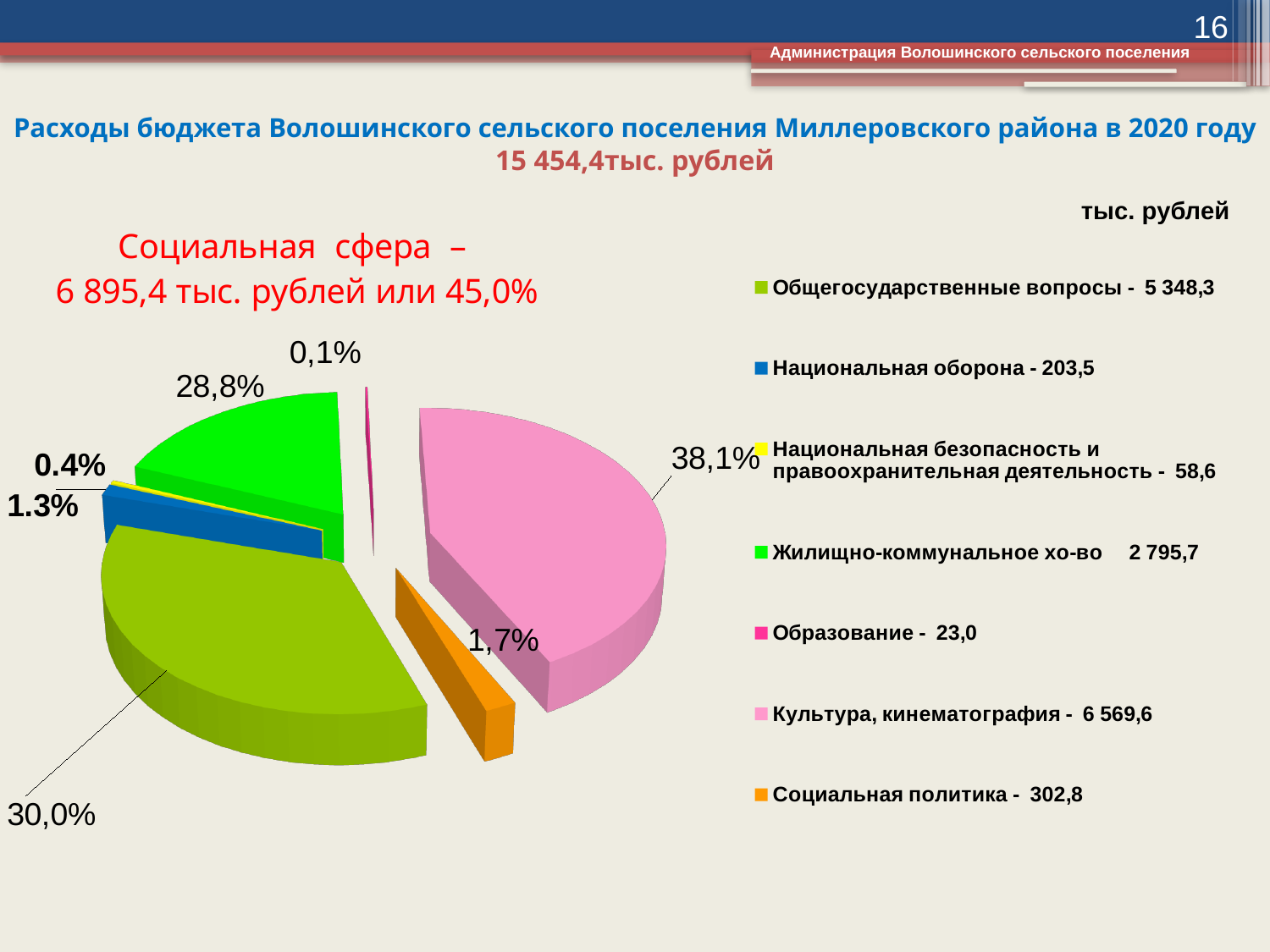
What value does the legend give for Образование? 23,0 What kind of chart is shown on the slide? pie chart What share of the pie is labelled for the Культура, кинематография slice? 38,1% How many categories does the legend of the pie chart list? 7 Which is larger: Национальная оборона or Социальная политика? Социальная политика Which category has the smallest slice of the pie? Образование Which category has the largest slice of the pie? Культура, кинематография What share of the pie is labelled for the Социальная политика slice? 1,7% What value does the legend give for Жилищно-коммунальное хо-во? 2 795,7 What value does the legend give for Общегосударственные вопросы? 5 348,3 What is the difference between the values for Культура, кинематография and Общегосударственные вопросы? 1 221,3 What value does the legend give for Культура, кинематография? 6 569,6